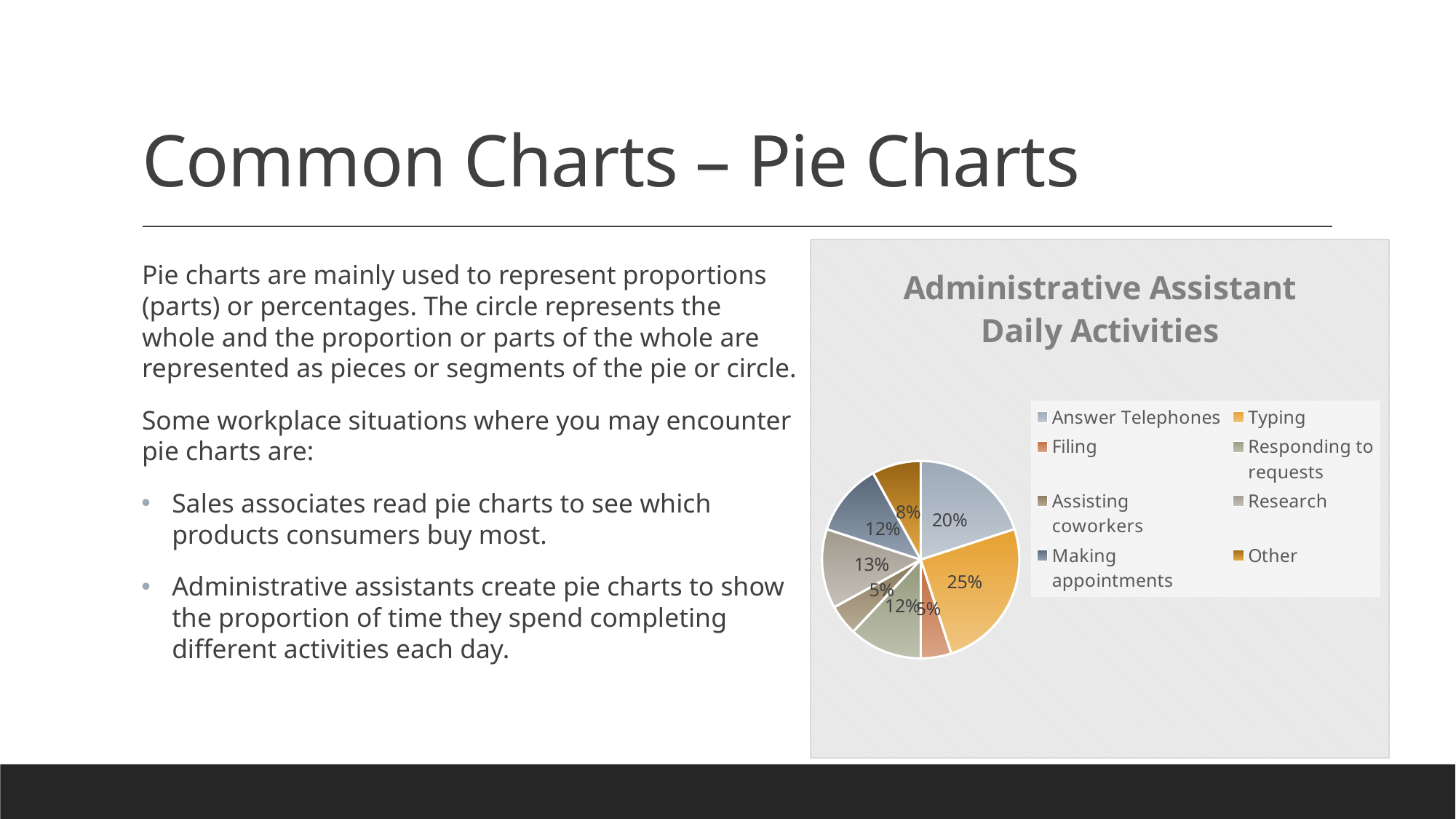
What share of the pie does Typing take? 25% What share of the pie does Answer Telephones take? 20% What share of the pie does Other take? 8% What kind of chart is shown on the slide? pie chart What is the title of the chart? Administrative Assistant Daily Activities How many categories does the legend of the pie chart list? 8 Which legend entry is shown in orange-red? Filing Which activity has the largest slice of the pie? Typing What share of the pie does Research take? 13% Which is larger, the Research slice or the Other slice? Research What share of the pie does Making appointments take? 12% What is the difference between the Typing share and the Answer Telephones share? 5%